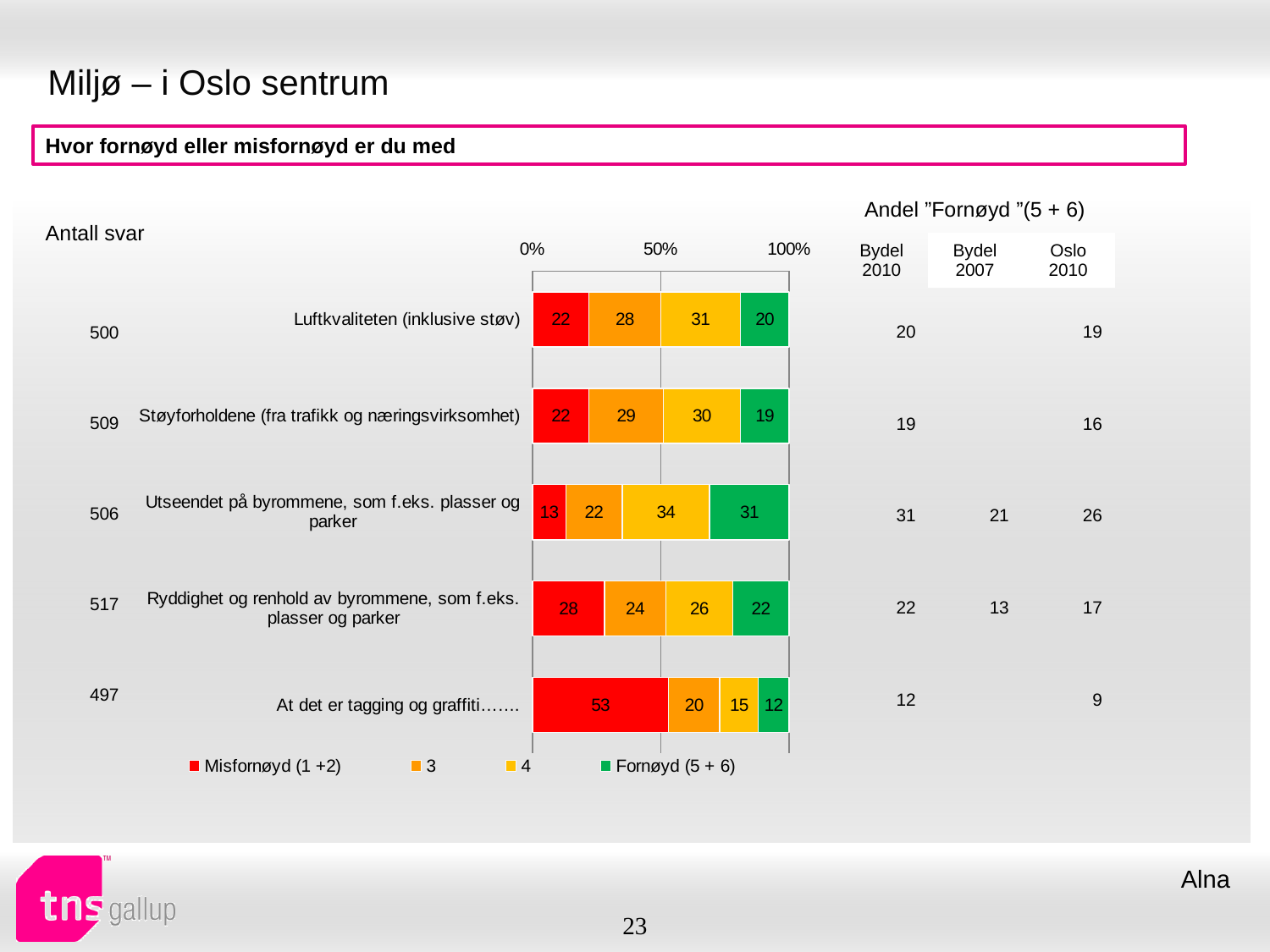
How many categories are shown in the chart? 5 Which category has the highest Misfornøyd (1 +2) value? At det er tagging og graffiti……. Which category has the lowest Fornøyd (5 + 6) value? At det er tagging og graffiti……. How many series does the legend list? 4 What is the value of the '3' segment for 'Støyforholdene (fra trafikk og næringsvirksomhet)'? 29 Which has a larger Misfornøyd (1 +2) value: 'Ryddighet og renhold av byrommene, som f.eks. plasser og parker' or 'Utseendet på byrommene, som f.eks. plasser og parker'? Ryddighet og renhold av byrommene, som f.eks. plasser og parker What is the difference between the Fornøyd (5 + 6) values for 'Utseendet på byrommene, som f.eks. plasser og parker' and 'Luftkvaliteten (inklusive støv)'? 11 What is the total of the stacked bar for 'Støyforholdene (fra trafikk og næringsvirksomhet)'? 100 What is the value of the Fornøyd (5 + 6) segment for 'Luftkvaliteten (inklusive støv)'? 20 What is the value of the '4' segment for 'Utseendet på byrommene, som f.eks. plasser og parker'? 34 What kind of chart is shown on the slide? Stacked bar chart What is the value of the Misfornøyd (1 +2) segment for 'At det er tagging og graffiti…….'? 53